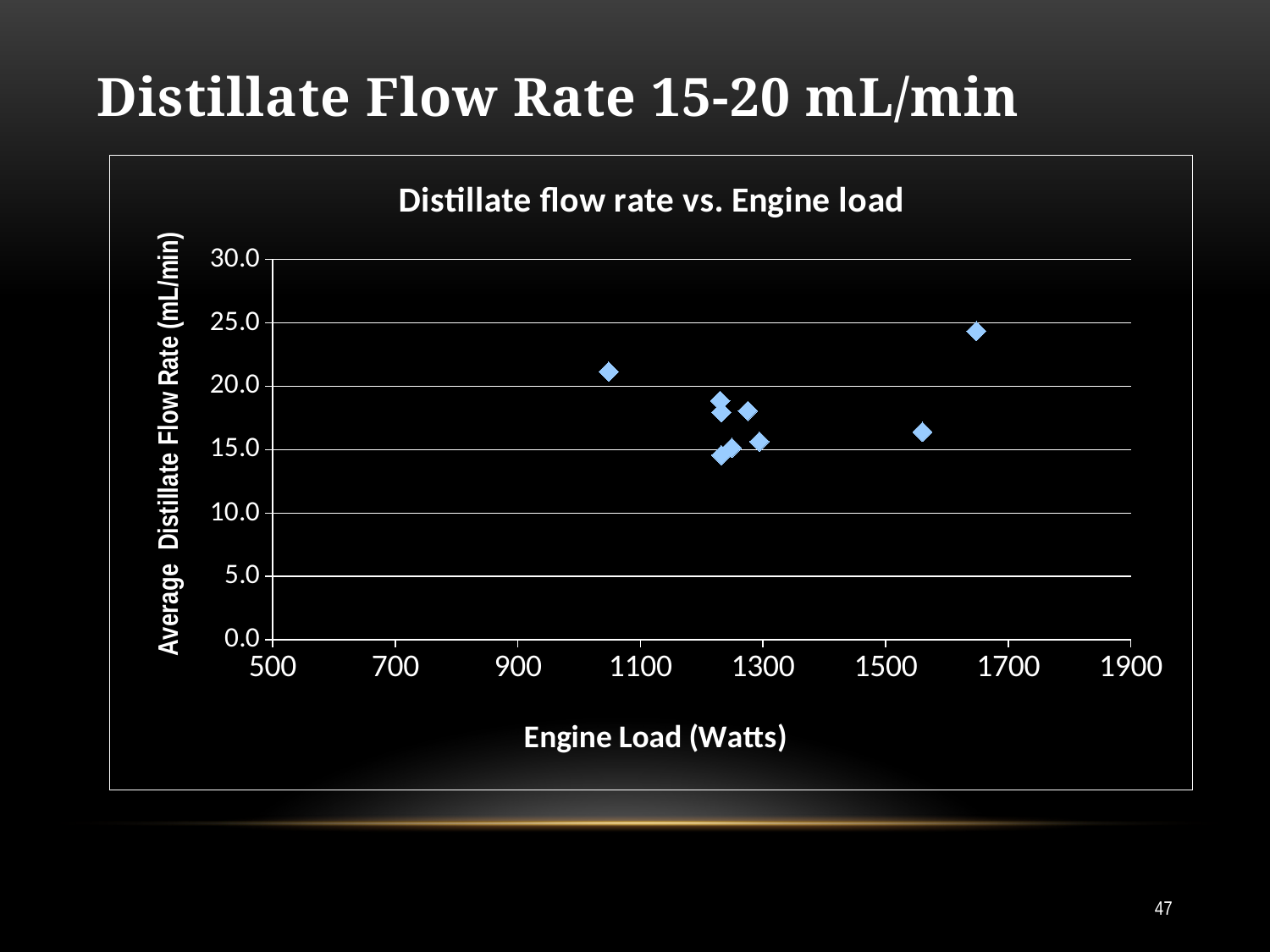
What is the title of the chart? Distillate flow rate vs. Engine load Is the point with the highest flow rate at an engine load above or below 1500 W? above What is the label of the x axis? Engine Load (Watts) Which has the higher flow rate: the point at roughly 1560 W or the point at roughly 1050 W? the point at roughly 1050 W How many plotted points lie at engine loads between 1500 and 1900 W? 2 Is the flow rate for the point at roughly 1560 W engine load greater or less than 20.0? less Is the flow rate for the point at roughly 1650 W engine load greater or less than 25.0? less Is the flow rate for the point at roughly 1650 W engine load greater or less than 20.0? greater What kind of chart is shown on the slide? scatter chart How many plotted points have a flow rate above 20.0 mL/min? 2 Which has the higher flow rate: the point at roughly 1650 W or the point at roughly 1050 W? the point at roughly 1650 W